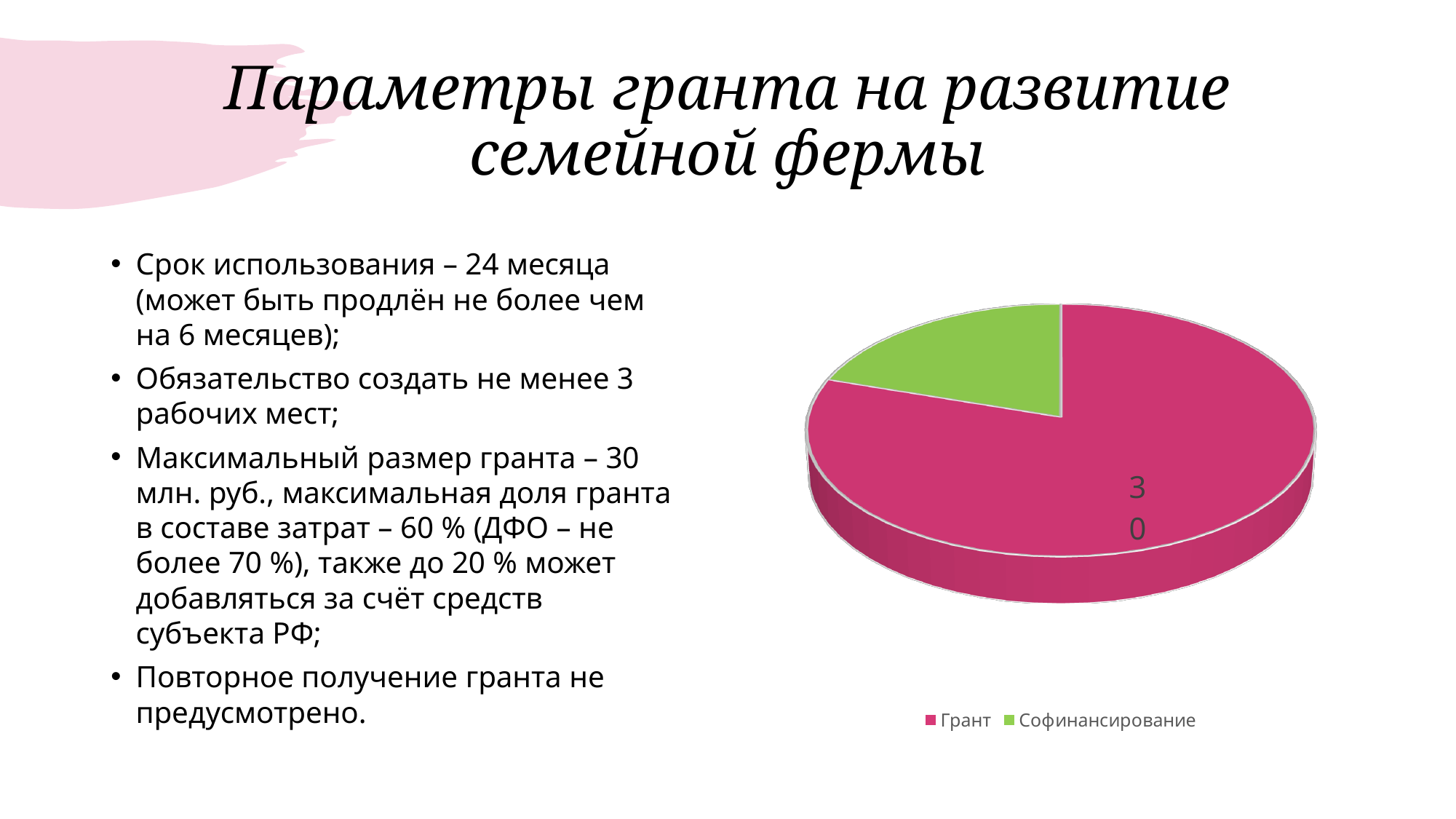
What colour is the Софинансирование slice in the pie chart? Green What kind of chart is shown on the slide? Pie chart How many slices does the pie chart have? 2 What colour is the Грант slice in the pie chart? Pink Which slice of the pie chart is the smallest? Софинансирование How many entries does the legend of the pie chart list? 2 What value is printed on the Грант slice of the pie chart? 30 Which slice of the pie chart is the largest? Грант Which slice is larger in the pie chart, Грант or Софинансирование? Грант